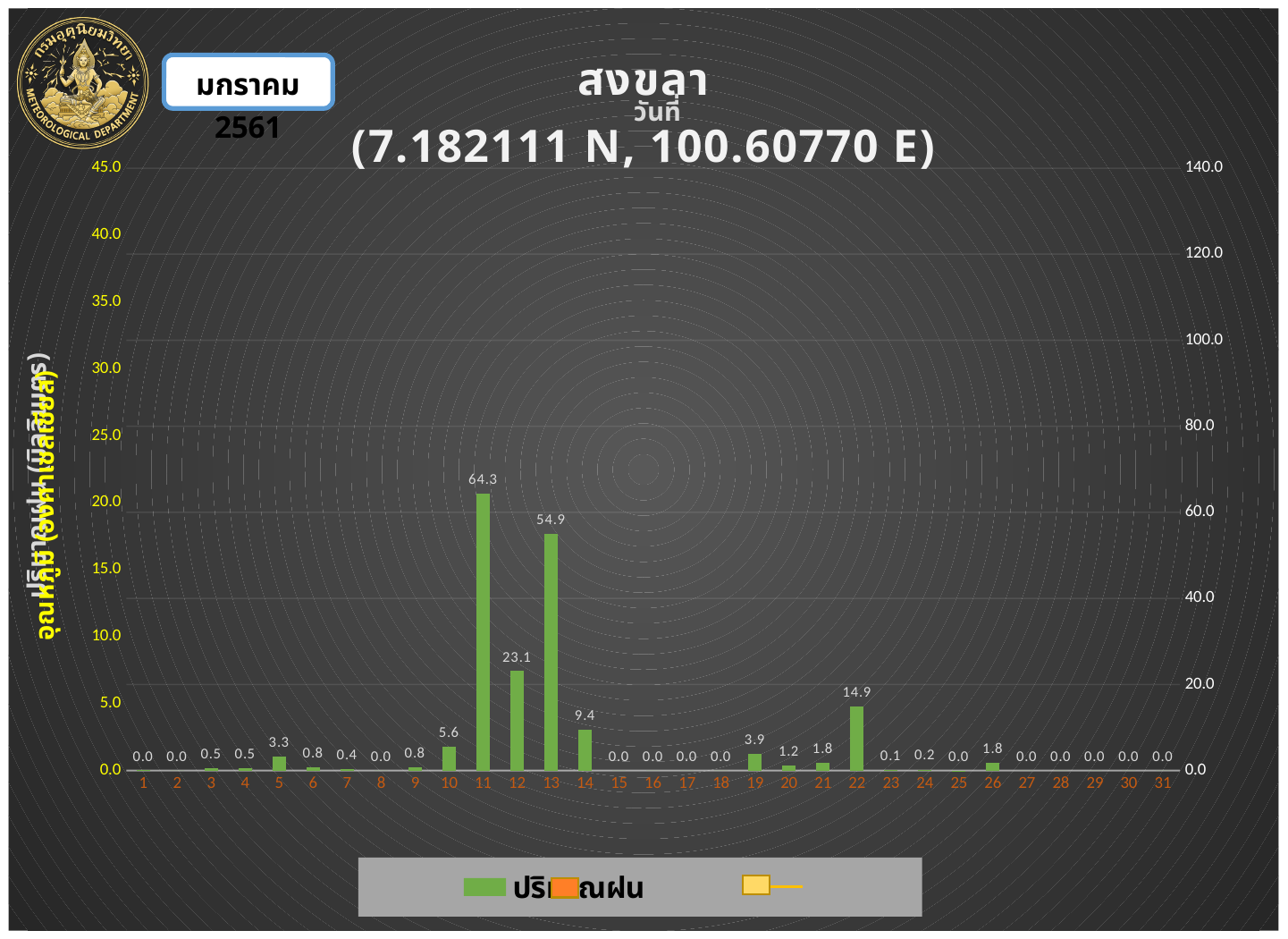
Which day has the highest value? 11 Which is larger, the value for day 10 or the value for day 19? day 10 What is the difference between the values for day 11 and day 13? 9.4 What is the value for day 22? 14.9 What is the difference between the values for day 12 and day 14? 13.7 What is the value for day 5? 3.3 What is the value for day 12? 23.1 Is the value for day 11 greater or less than 60.0 on the right axis? greater How many days are shown on the x axis? 31 What is the value for day 11? 64.3 What kind of chart is this? bar chart What is the value for day 13? 54.9